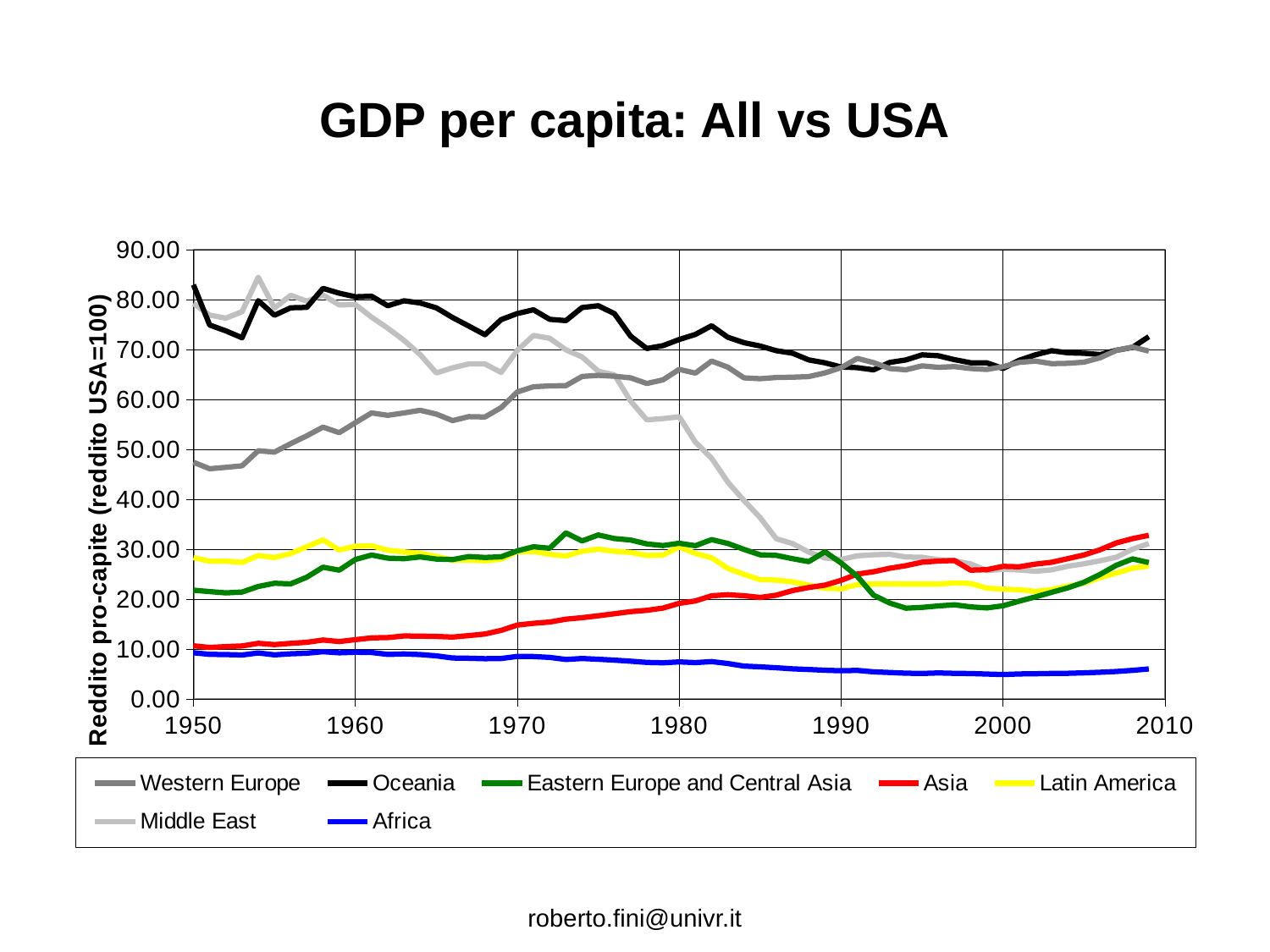
Which series has the lowest values across the whole period? Africa How many series does the legend list? 7 What is the label on the vertical axis? Reddito pro-capite (reddito USA=100) What kind of chart is shown on the slide? line chart In 1950, which is larger: Middle East or Western Europe? Middle East Does the Western Europe line rise or fall overall from 1950 to 2010? rise Does the Asia line rise or fall overall from 1950 to 2010? rise Is the value for Middle East in 1985 greater or less than 50.00? less What is the title of the chart? GDP per capita: All vs USA Does the Middle East line rise or fall overall from 1950 to 2010? fall Which series has the highest value in 1950? Oceania Is the value for Western Europe in 1950 greater or less than 50.00? less